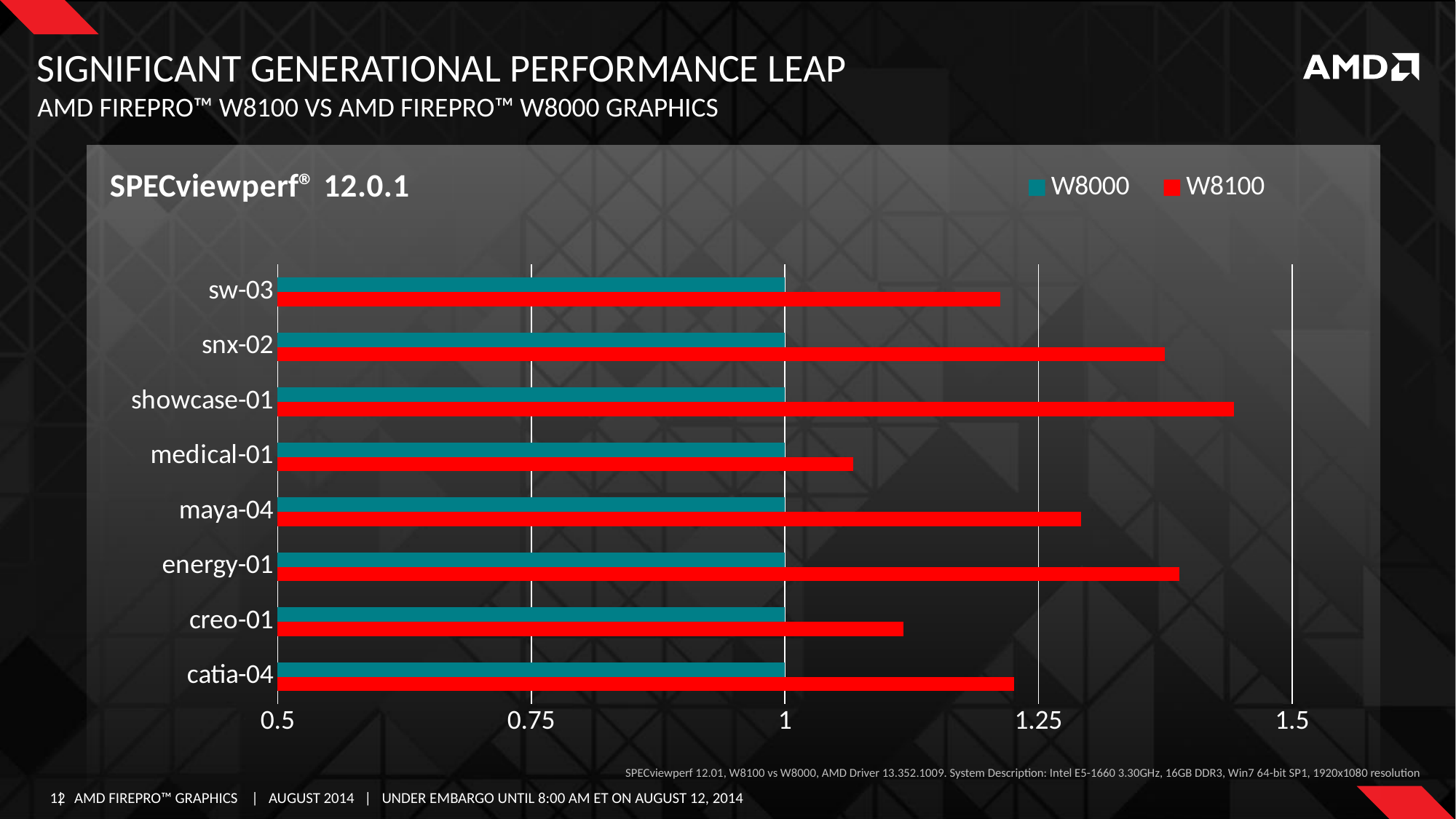
Is the W8100 value for creo-01 greater or less than 1.25? less What is the W8000 value for sw-03? 1 What kind of chart is shown on the slide? bar chart Which category has the highest W8100 value? showcase-01 How many series does the legend list? 2 Which has the larger W8100 value, energy-01 or maya-04? energy-01 Which category has the lowest W8100 value? medical-01 What is the W8000 value for catia-04? 1 How many benchmark categories are plotted on the chart? 8 What colour are the W8100 bars? red Is the W8100 value for showcase-01 greater or less than 1.5? less Is the W8100 value for snx-02 greater or less than 1.25? greater